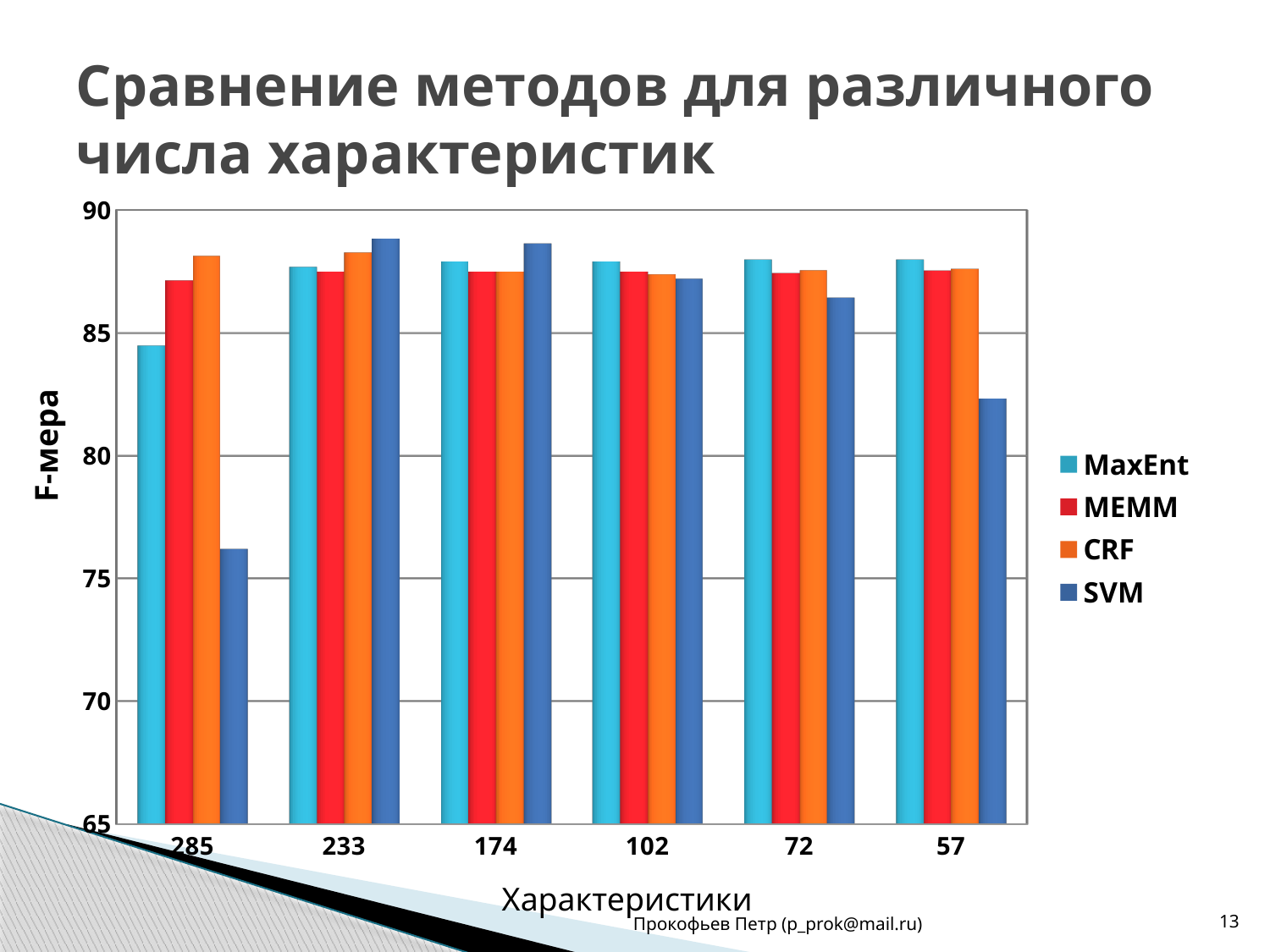
Which method has the highest value at 285 characteristics? CRF Is the value for CRF at 285 characteristics greater or less than 85? greater What is the label of the vertical axis of the chart? F-мера How many series does the chart's legend list? 4 Which series is shown in orange in the chart's legend? CRF Which method has the lowest value at 285 characteristics? SVM At 57 characteristics, which is larger: the value for MaxEnt or the value for SVM? MaxEnt What kind of chart is shown on the slide? bar chart Is the value for SVM at 57 characteristics greater or less than 85? less How many categories are shown on the x axis of the chart? 6 Which method has the highest value at 233 characteristics? SVM Is the value for SVM at 285 characteristics greater or less than 80? less